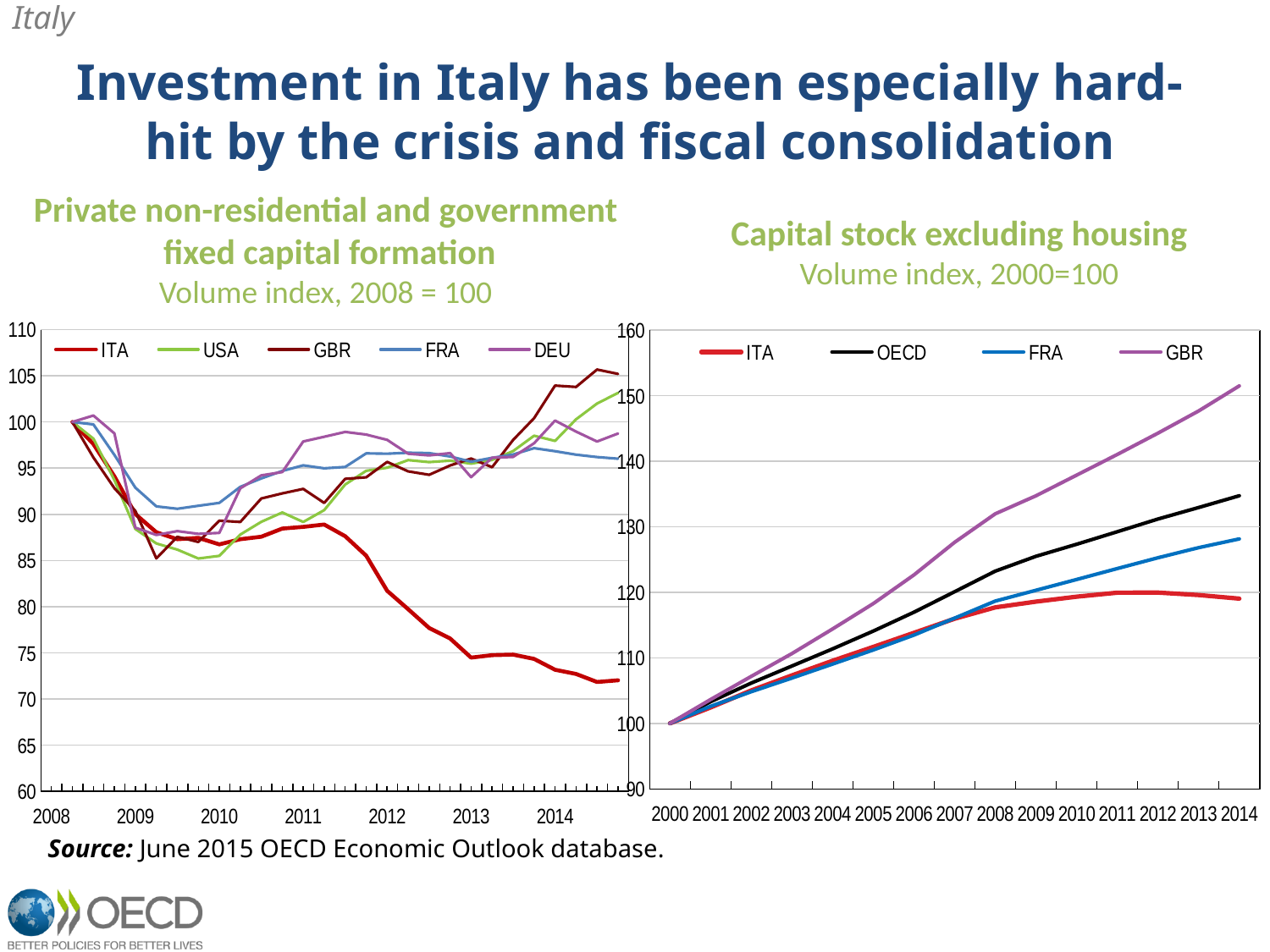
In the right chart, is the value for ITA in 2014 greater or less than 130? less In the left chart, does the ITA series rise or fall overall from 2008 to 2014? fall In the left chart, is the value for ITA at the end of 2014 greater or less than 75? less In the right chart, which is larger in 2014: OECD or FRA? OECD In the right chart, which series has the highest value in 2014? GBR How many series does the legend of the left chart list? 5 How many series does the legend of the right chart, 'Capital stock excluding housing', list? 4 In the right chart, which series has the lowest value in 2014? ITA In the left chart, which series has the lowest value at the end of 2014? ITA In the right chart, what is the value for ITA in 2000? 100 In the right chart, is the value for GBR in 2014 greater or less than 140? greater What kind of chart is the left chart, 'Private non-residential and government fixed capital formation'? line chart